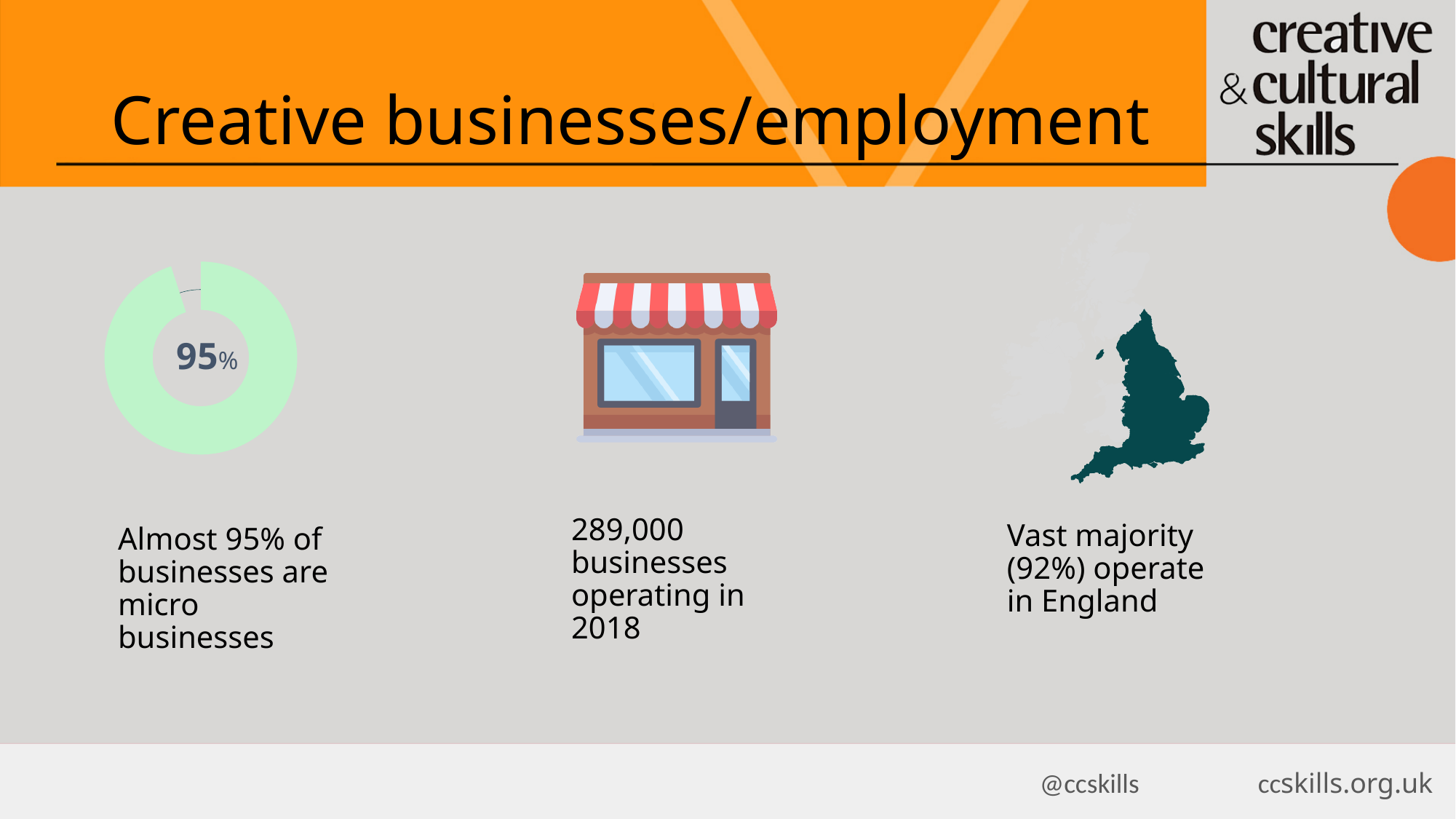
What value is printed in the centre of the doughnut chart? 95% What kind of chart is shown on the left of the slide? Doughnut (pie) chart Is the value shown in the doughnut chart greater or less than 50%? greater What colour is the large slice of the doughnut chart? Light green What share of the doughnut chart does the large green slice represent? 95% According to the caption under the doughnut chart, what does the 95% represent? Businesses that are micro businesses How many slices does the doughnut chart have? 2 Which slice of the doughnut chart is larger, the green slice or the small gap slice? The green slice